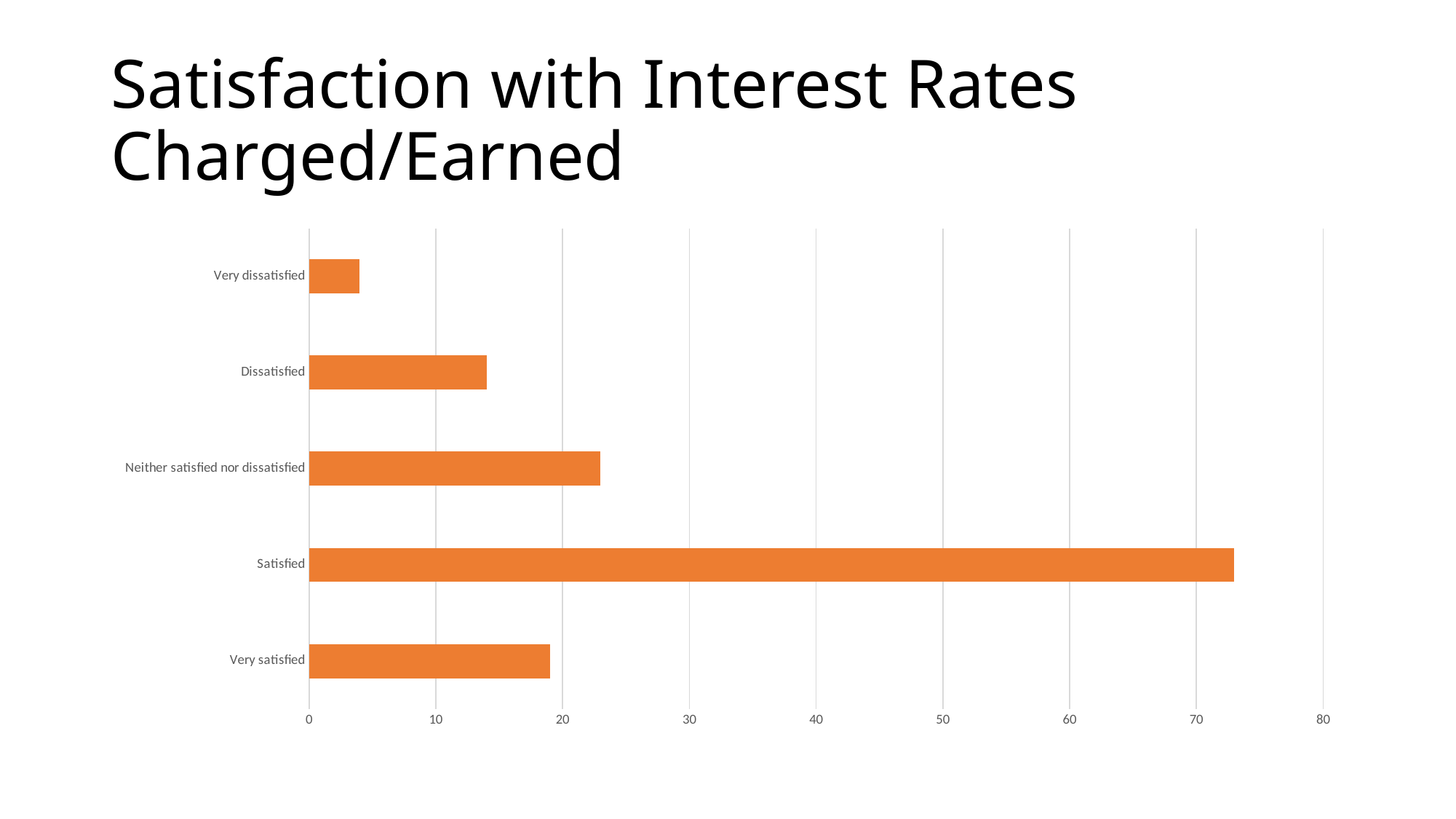
How many categories are plotted in the chart? 5 Which is larger, the value for Satisfied or the value for Very satisfied? Satisfied Is the value for Dissatisfied greater or less than 10? greater Is the value for Very satisfied greater or less than 10? greater Which is larger, the value for Neither satisfied nor dissatisfied or the value for Dissatisfied? Neither satisfied nor dissatisfied Is the value for Neither satisfied nor dissatisfied greater or less than 30? less What kind of chart is shown on the slide? bar chart What is the title of the slide? Satisfaction with Interest Rates Charged/Earned Which category has the highest value? Satisfied Which category has the lowest value? Very dissatisfied